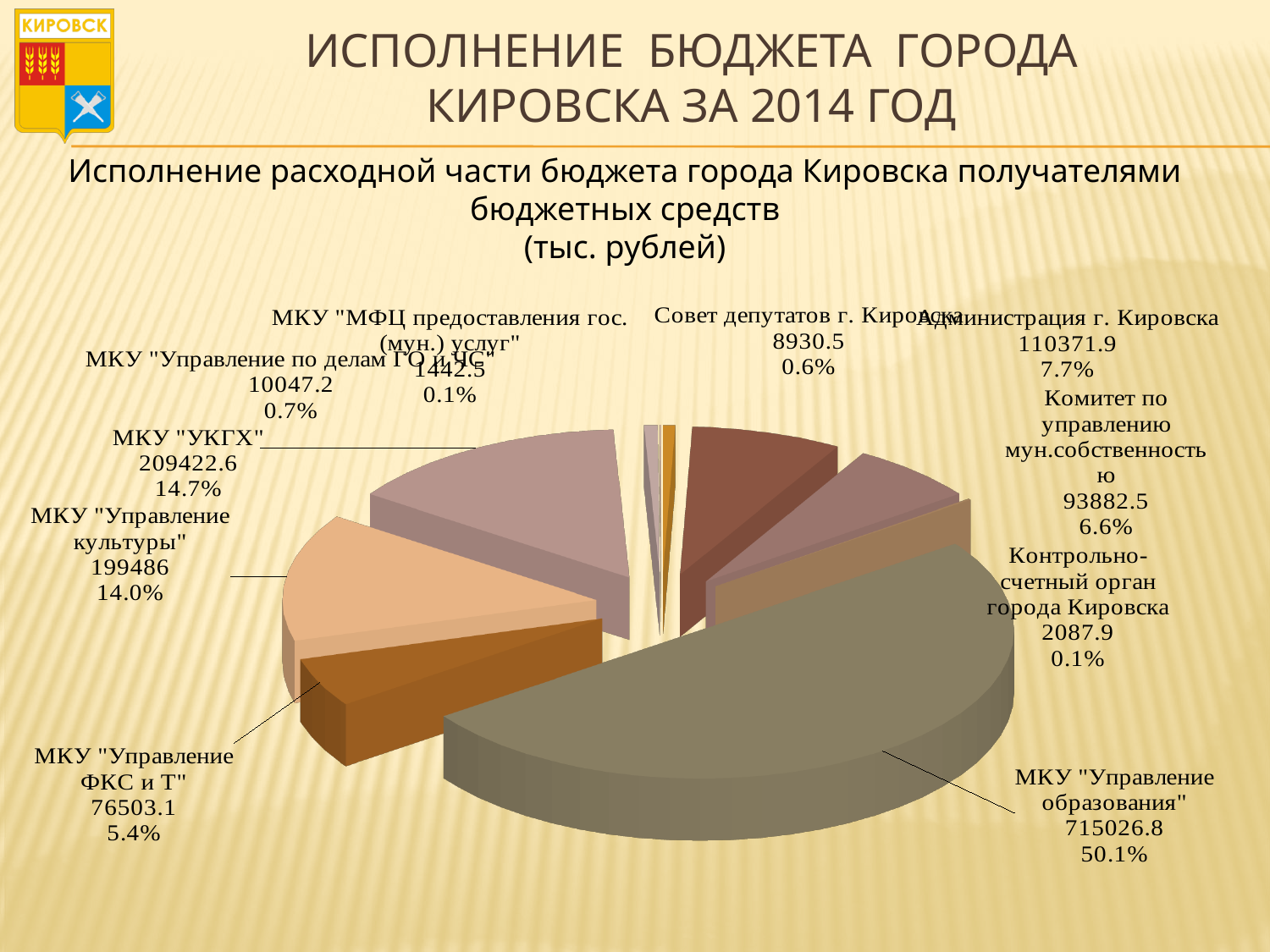
How many categories (slices) does the pie chart show? 10 What is the value for Совет депутатов г. Кировска? 8930.5 What is the value for МКУ "Управление образования"? 715026.8 What type of chart is shown on the slide? Pie chart Which category has the largest slice of the pie? МКУ "Управление образования" Which is larger: the value for Администрация г. Кировска or the value for Комитет по управлению мун.собственностью? Администрация г. Кировска Which category has the smallest value in the pie chart? МКУ "МФЦ предоставления гос. (мун.) услуг" What share of the pie does МКУ "Управление образования" represent? 50.1% In what units are the values in the chart given, according to the subtitle? тыс. рублей What is the difference between the values for МКУ "УКГХ" and МКУ "Управление культуры"? 9936.6 What is the value for Администрация г. Кировска? 110371.9 What share of the pie does МКУ "УКГХ" represent? 14.7%